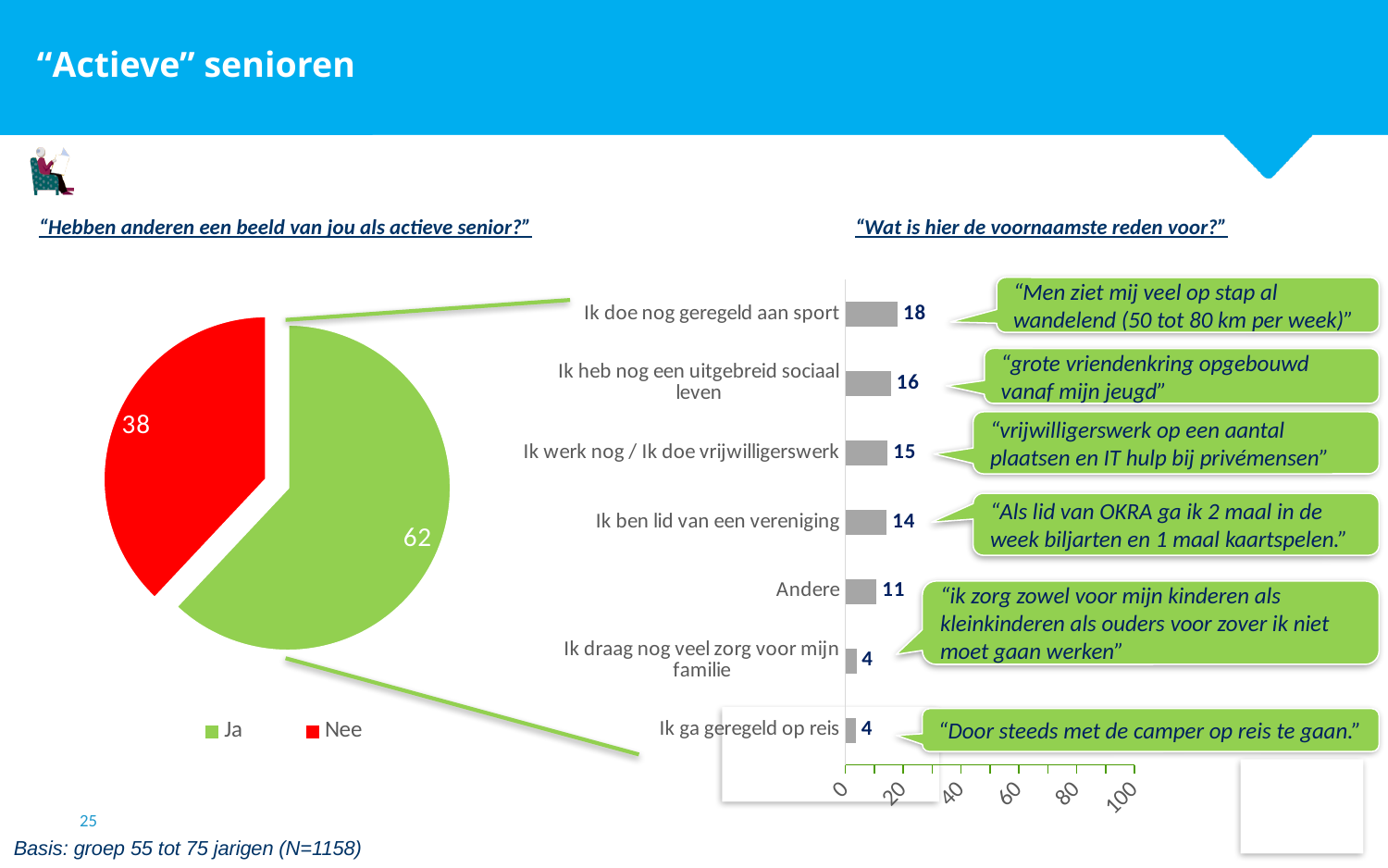
In the bar chart on the right, which category has the highest value? Ik doe nog geregeld aan sport In the pie chart on the left, what is the value for "Ja"? 62 What kind of chart is the chart on the left of the slide? Pie chart How many entries does the legend of the pie chart on the left list? 2 In the bar chart on the right, what is the value for "Ik ben lid van een vereniging"? 14 How many categories are shown in the bar chart on the right? 7 In the bar chart on the right, what is the difference between "Ik heb nog een uitgebreid sociaal leven" and "Andere"? 5 What kind of chart is the chart on the right of the slide? Bar chart In the pie chart on the left, what is the difference between the "Ja" and "Nee" values? 24 In the pie chart on the left, what is the value for "Nee"? 38 In the pie chart on the left, which slice is larger, "Ja" or "Nee"? Ja In the bar chart on the right, what is the value for "Ik doe nog geregeld aan sport"? 18